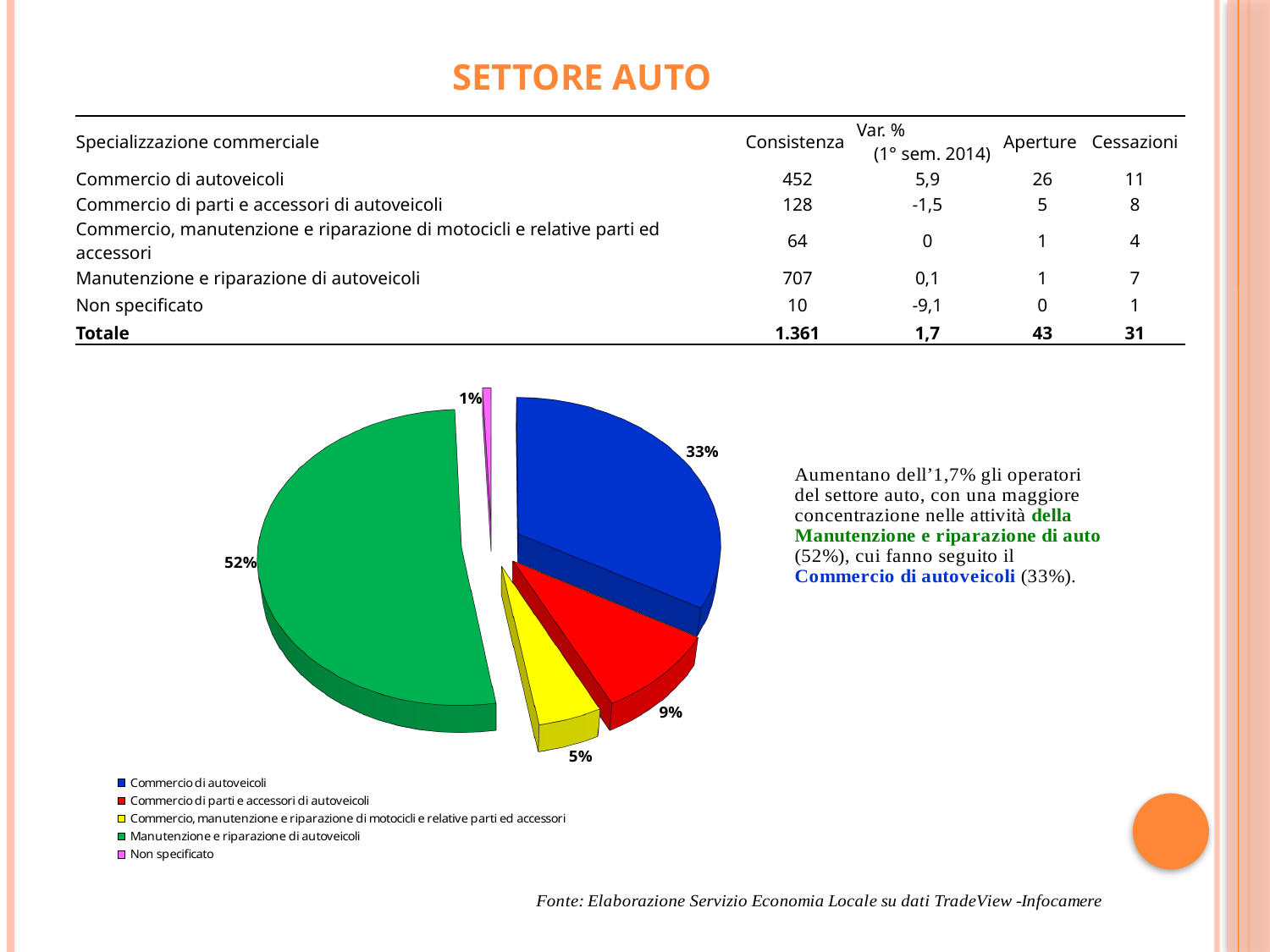
Which slice is larger: Commercio di parti e accessori di autoveicoli or Commercio, manutenzione e riparazione di motocicli e relative parti ed accessori? Commercio di parti e accessori di autoveicoli What is the difference in percentage points between the Manutenzione e riparazione di autoveicoli slice and the Commercio di autoveicoli slice? 19 What type of chart is shown on the slide? Pie chart What colour is the slice for Manutenzione e riparazione di autoveicoli in the pie chart? Green Which category has the smallest slice in the pie chart? Non specificato What share of the pie chart does Commercio di parti e accessori di autoveicoli represent? 9% Which category does the yellow slice of the pie chart represent? Commercio, manutenzione e riparazione di motocicli e relative parti ed accessori Which category has the largest slice in the pie chart? Manutenzione e riparazione di autoveicoli What share of the pie chart does Manutenzione e riparazione di autoveicoli represent? 52% What share of the pie chart does Commercio di autoveicoli represent? 33% How many slices does the pie chart have? 5